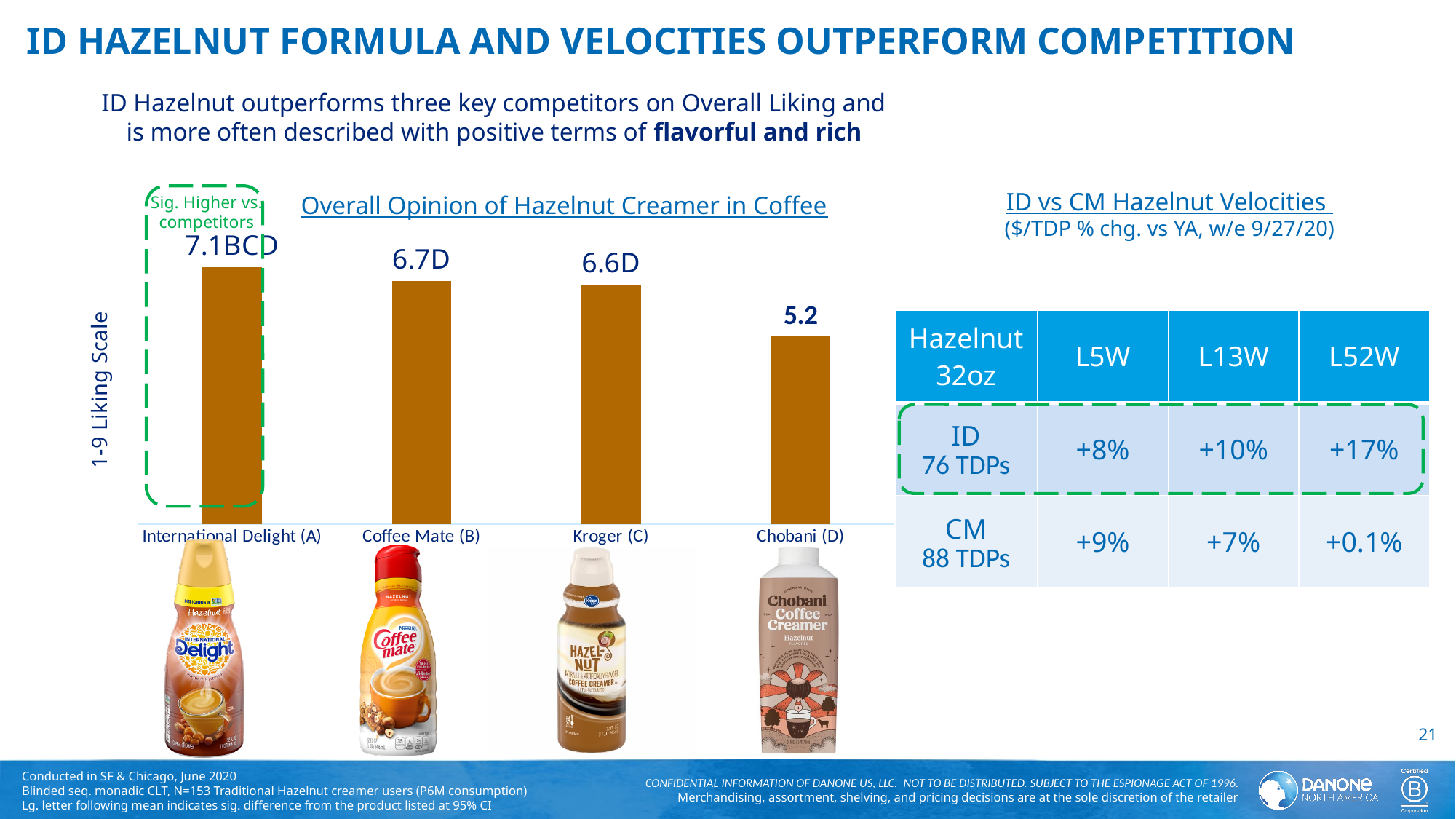
Which has a higher Overall Opinion score, Coffee Mate (B) or Kroger (C)? Coffee Mate (B) What is the label on the vertical axis of the Overall Opinion bar chart? 1-9 Liking Scale What is the Overall Opinion score for International Delight (A)? 7.1 What type of chart is used to show the Overall Opinion of Hazelnut Creamer in Coffee? Bar chart What is the Overall Opinion score for Kroger (C)? 6.6 What is the Overall Opinion score for Coffee Mate (B)? 6.7 How many brands are shown in the Overall Opinion bar chart? 4 Which brand has the highest Overall Opinion score in the bar chart? International Delight (A) What is the difference between the Overall Opinion scores of International Delight (A) and Chobani (D)? 1.9 What is the difference between the Overall Opinion scores of International Delight (A) and Coffee Mate (B)? 0.4 Which brand has the lowest Overall Opinion score in the bar chart? Chobani (D) What is the Overall Opinion score for Chobani (D)? 5.2